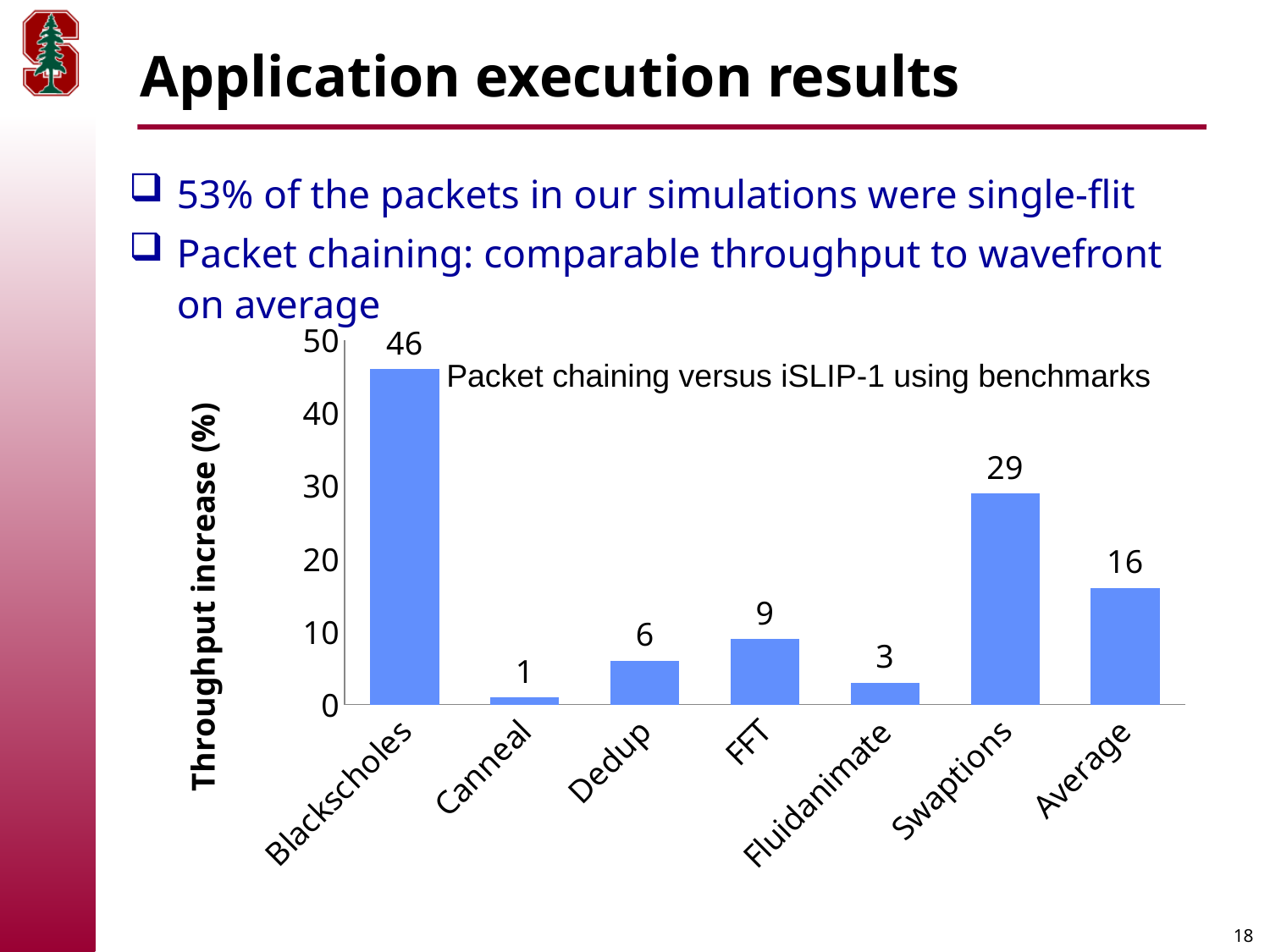
What kind of chart is shown on the slide? bar chart Which has a larger throughput increase, Dedup or FFT? FFT How many categories are shown on the x axis? 7 Is the value for Swaptions greater or less than 20? greater What is the throughput increase for Swaptions? 29 What is the difference between the throughput increase for Blackscholes and Swaptions? 17 Which benchmark has the highest throughput increase? Blackscholes What is the throughput increase for Fluidanimate? 3 What is the title of the chart? Packet chaining versus iSLIP-1 using benchmarks What is the throughput increase for Blackscholes? 46 What is the value shown for Average? 16 Which benchmark has the lowest throughput increase? Canneal